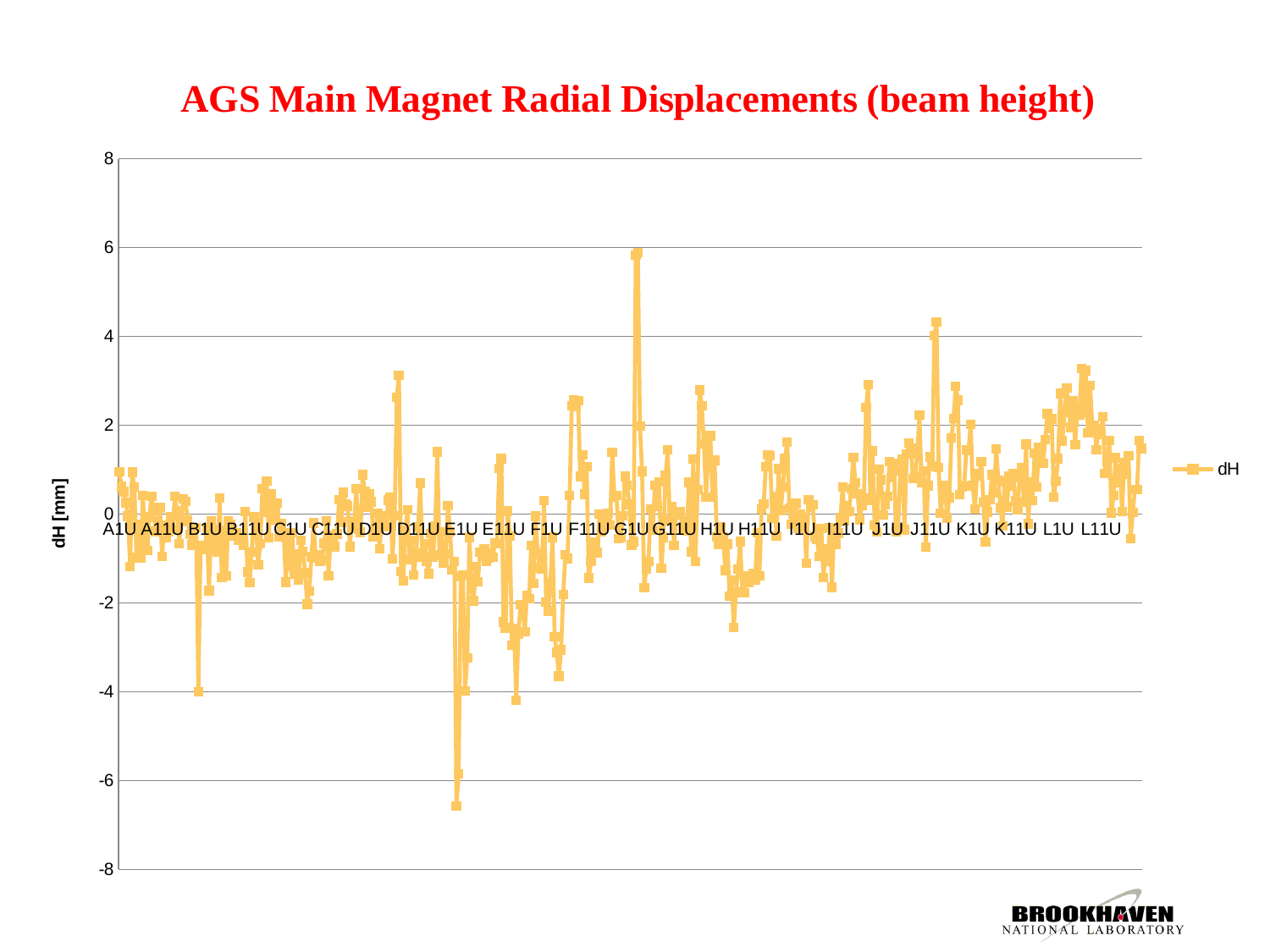
Near which x-axis label does the dH series reach its lowest value? E1U What is the highest value shown on the vertical axis? 8 What is the title of the chart? AGS Main Magnet Radial Displacements (beam height) What is the label of the vertical axis? dH [mm] Is the lowest point of the dH series (near E1U) greater or less than -6? less Is the peak near J11U greater or less than 2? greater How many series does the legend list? 1 How many labels are shown along the x axis? 24 What kind of chart is shown on the slide? line chart Is the sharp dip near B1U greater or less than -2? less Near which x-axis label does the dH series reach its highest value? G1U